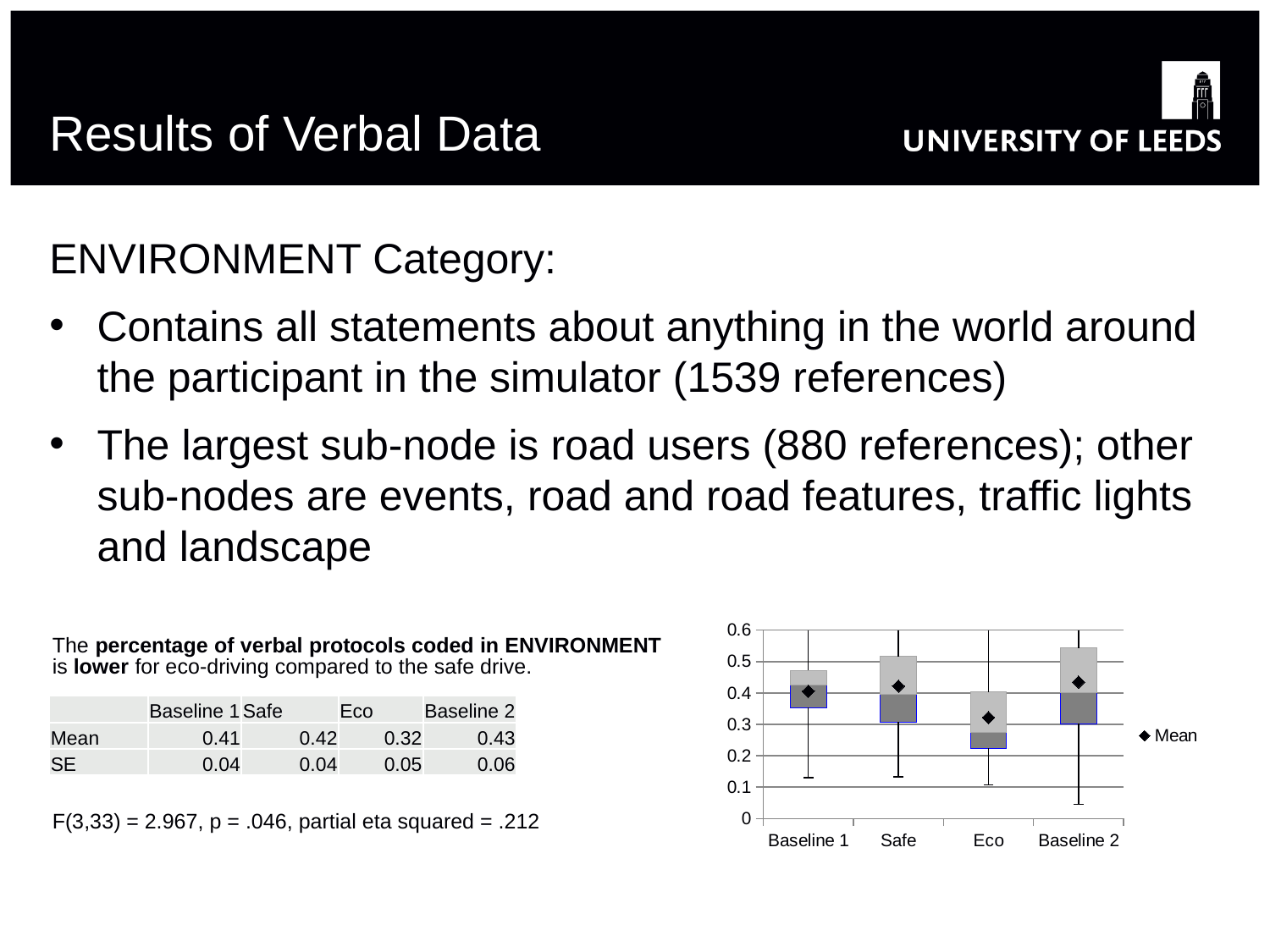
Which has the higher mean marker in the chart, Safe or Eco? Safe Which category has the lowest mean marker in the chart? Eco Is the mean marker for Baseline 2 greater or less than 0.4? greater What is the highest value shown on the chart's y axis? 0.6 Is the mean marker for Eco greater or less than 0.2? greater According to the table on the slide, what is the mean for Eco? 0.32 Is the mean marker for Eco greater or less than 0.4? less What does the diamond marker in the chart represent, according to the legend? Mean How many categories are shown on the x axis of the chart? 4 What kind of chart is shown at the bottom right of the slide? box plot How many entries does the chart's legend list? 1